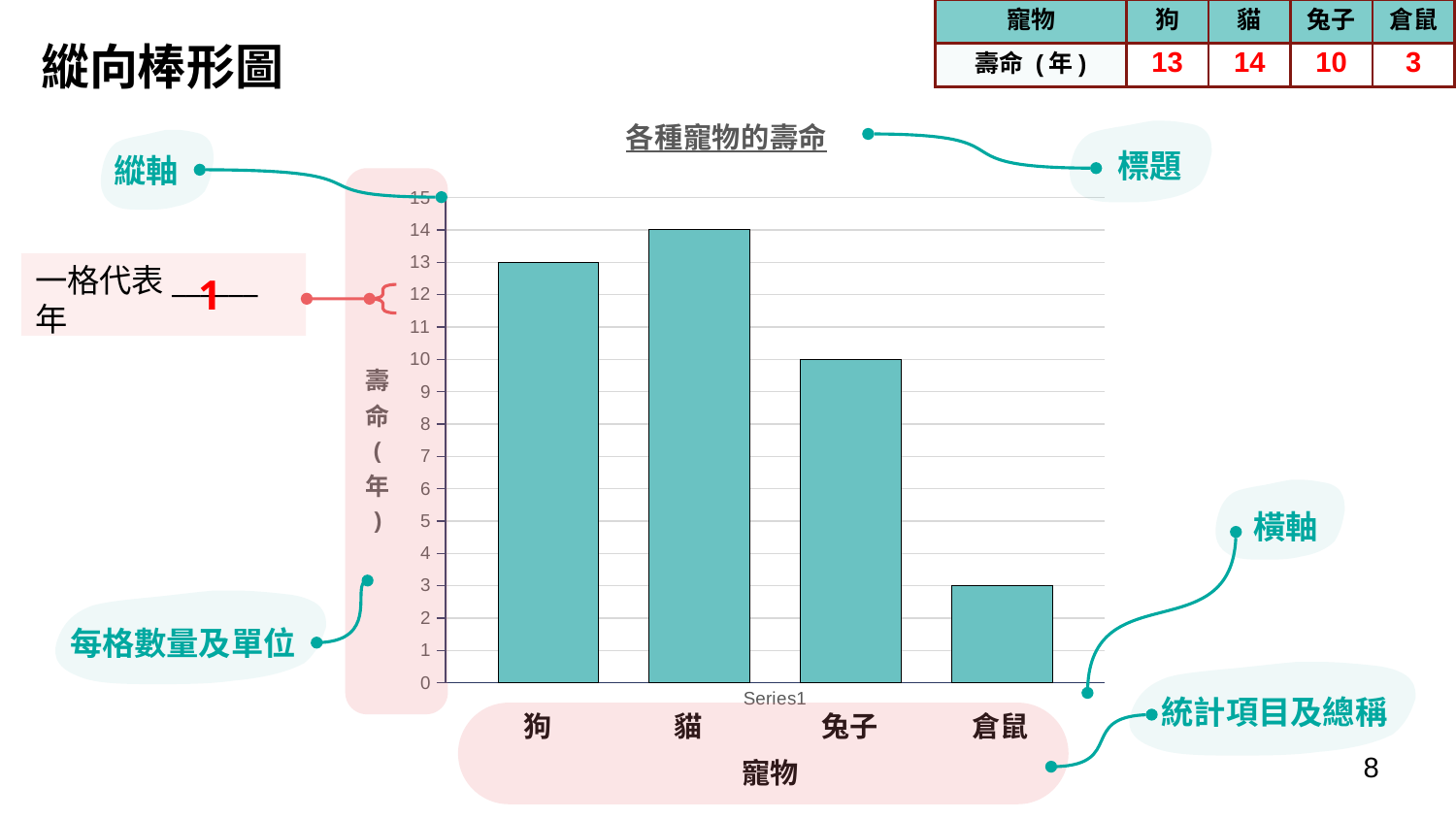
What is the difference between the values for 狗 and 兔子? 3 What is the lifespan value for 貓 in the chart? 14 What is the lifespan value for 狗 in the chart? 13 Which pet has the lowest bar in the chart? 倉鼠 What is the difference between the values for 貓 and 倉鼠? 11 How many pet categories are shown on the x axis of the chart? 4 Is the value for 兔子 greater or less than 5? greater What is the title of the chart? 各種寵物的壽命 What is the lifespan value for 倉鼠 in the chart? 3 Which is larger, the value for 狗 or the value for 兔子? 狗 What kind of chart is shown on the slide? bar chart Which pet has the highest bar in the chart? 貓